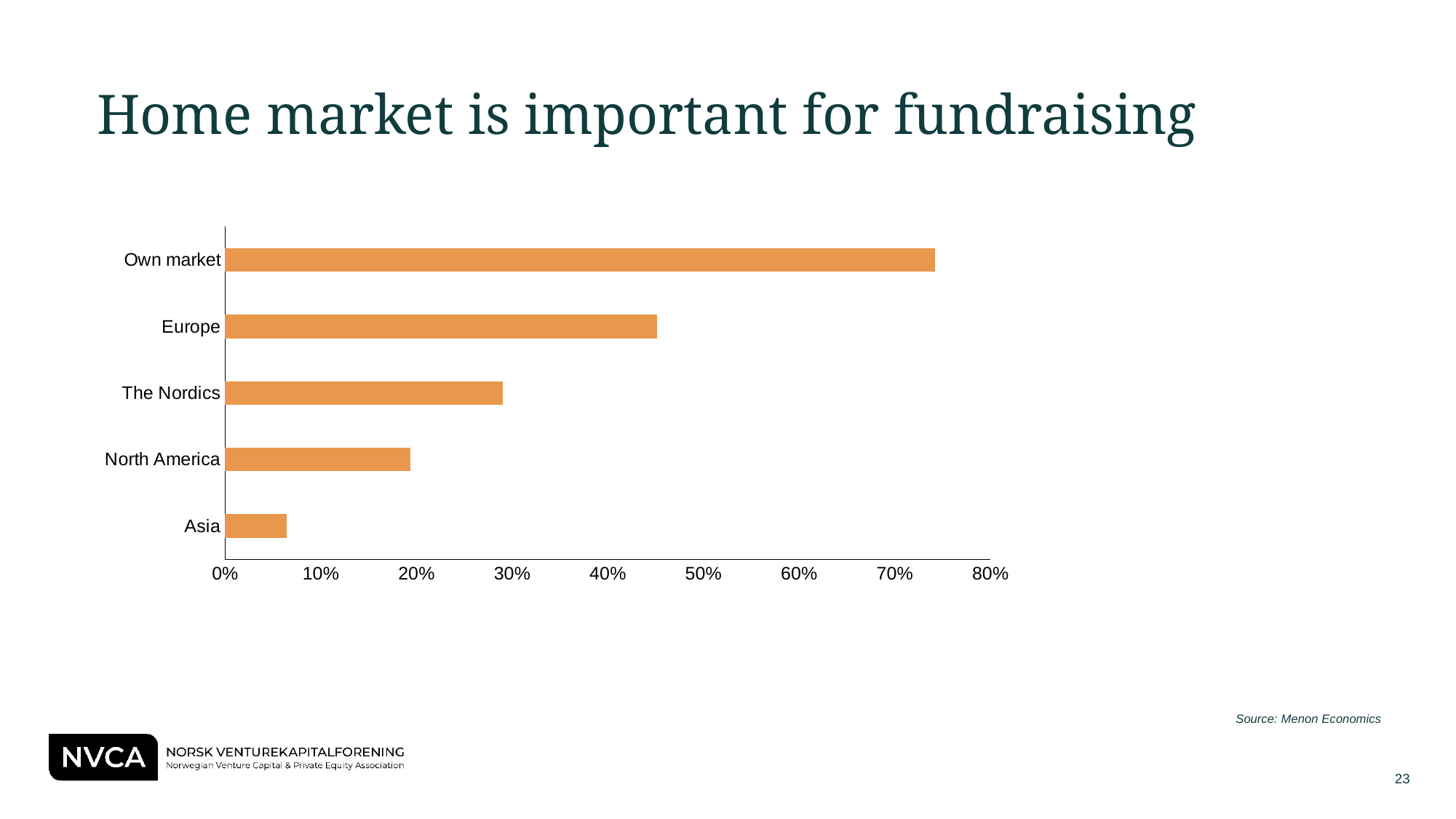
Is the value for Asia greater or less than 10%? less How many categories are shown in the chart? 5 Is the value for The Nordics greater or less than 20%? greater Which category has the lowest value in the chart? Asia Which category has the highest value in the chart? Own market Is the value for Own market greater or less than 70%? greater Which has a larger value, The Nordics or Asia? The Nordics What kind of chart is shown on the slide? bar chart What is the title of the slide? Home market is important for fundraising Which has a larger value, Europe or North America? Europe